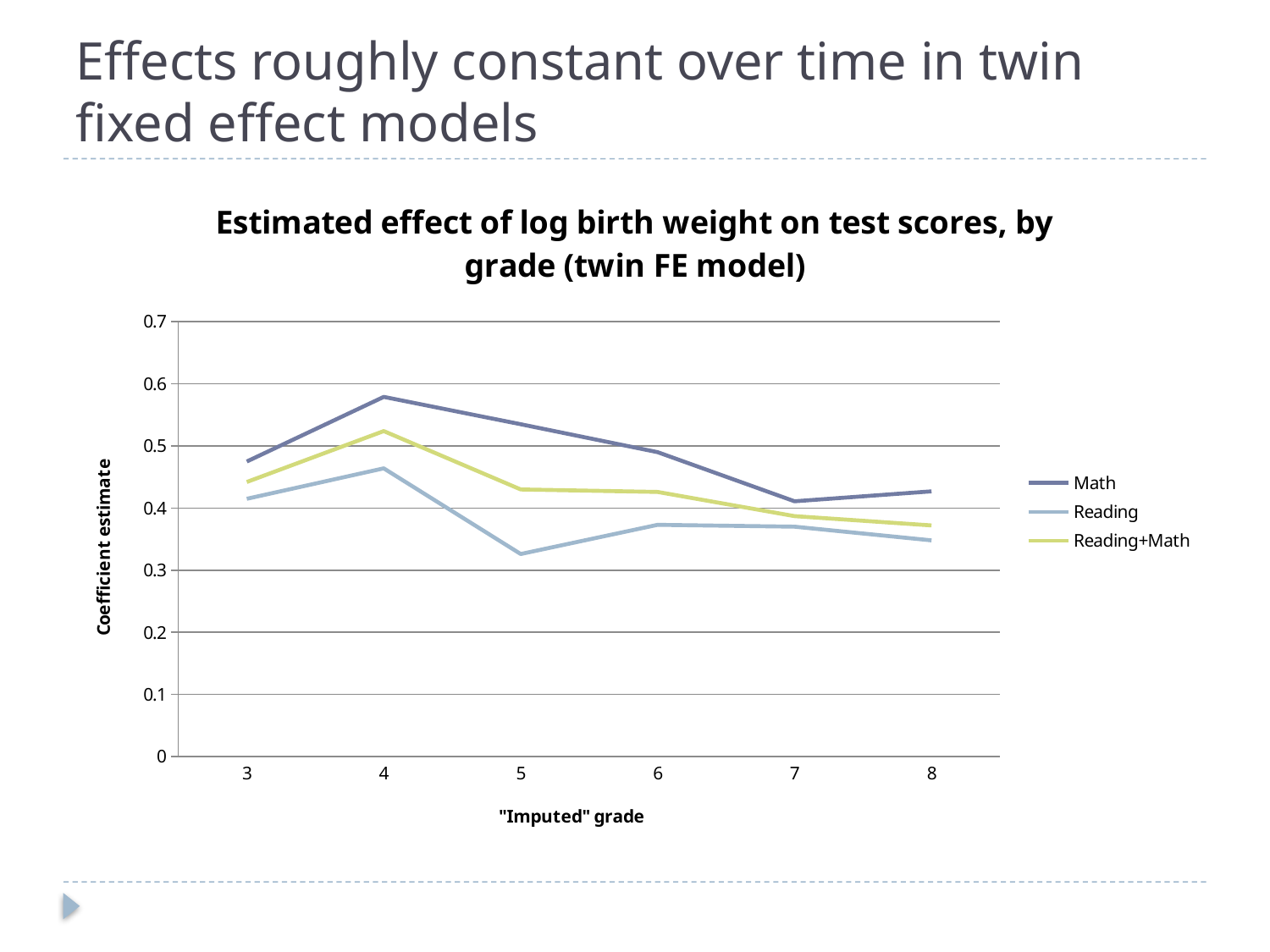
How many grades are plotted along the x axis? 6 What type of chart is shown on the slide? line chart Is the Reading value at grade 5 greater or less than 0.4? less At which grade is the Math coefficient estimate highest? 4 Is the Math value at grade 4 greater or less than 0.5? greater At which grade is the Reading coefficient estimate lowest? 5 What is the title of the y axis? Coefficient estimate How many series does the legend list? 3 At grade 4, which series has the larger value, Math or Reading? Math At which grade is the Reading+Math coefficient estimate highest? 4 Does the Math series rise or fall from grade 4 to grade 7? fall Is the Reading+Math value at grade 8 greater or less than 0.4? less